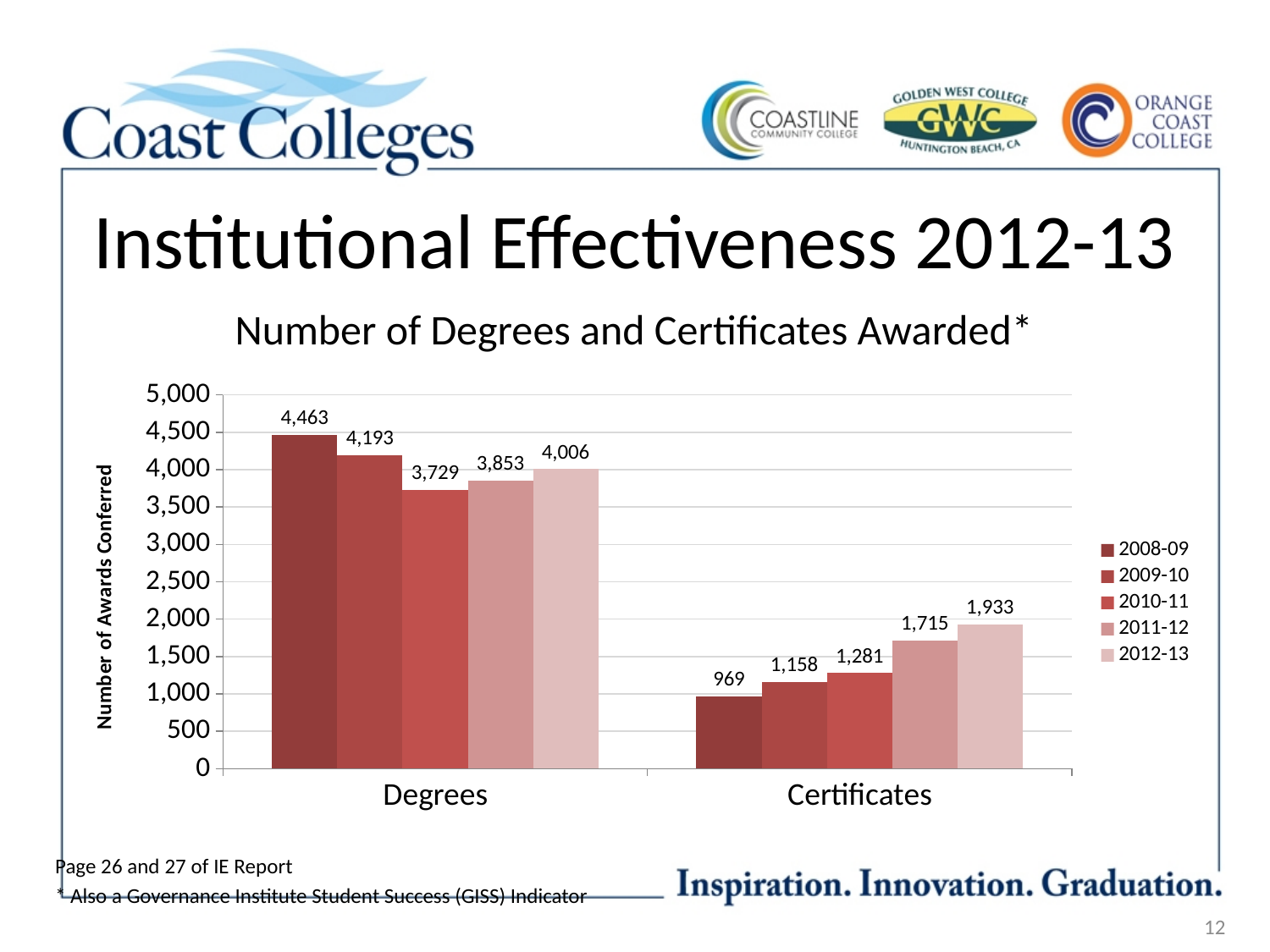
Which year has the highest number of degrees awarded? 2008-09 What kind of chart is shown on the slide? bar chart Which is larger: degrees awarded in 2011-12 or degrees awarded in 2012-13? 2012-13 What is the value for Degrees in 2010-11? 3,729 Which year has the lowest number of certificates awarded? 2008-09 How many series does the legend list? 5 Do the certificate values rise or fall from 2008-09 to 2012-13? rise How many certificates were awarded in 2012-13? 1,933 How many degrees were awarded in 2008-09? 4,463 What is the difference between degrees awarded in 2008-09 and 2010-11? 734 What is the difference between certificates awarded in 2012-13 and 2008-09? 964 What is the title of the chart? Number of Degrees and Certificates Awarded*